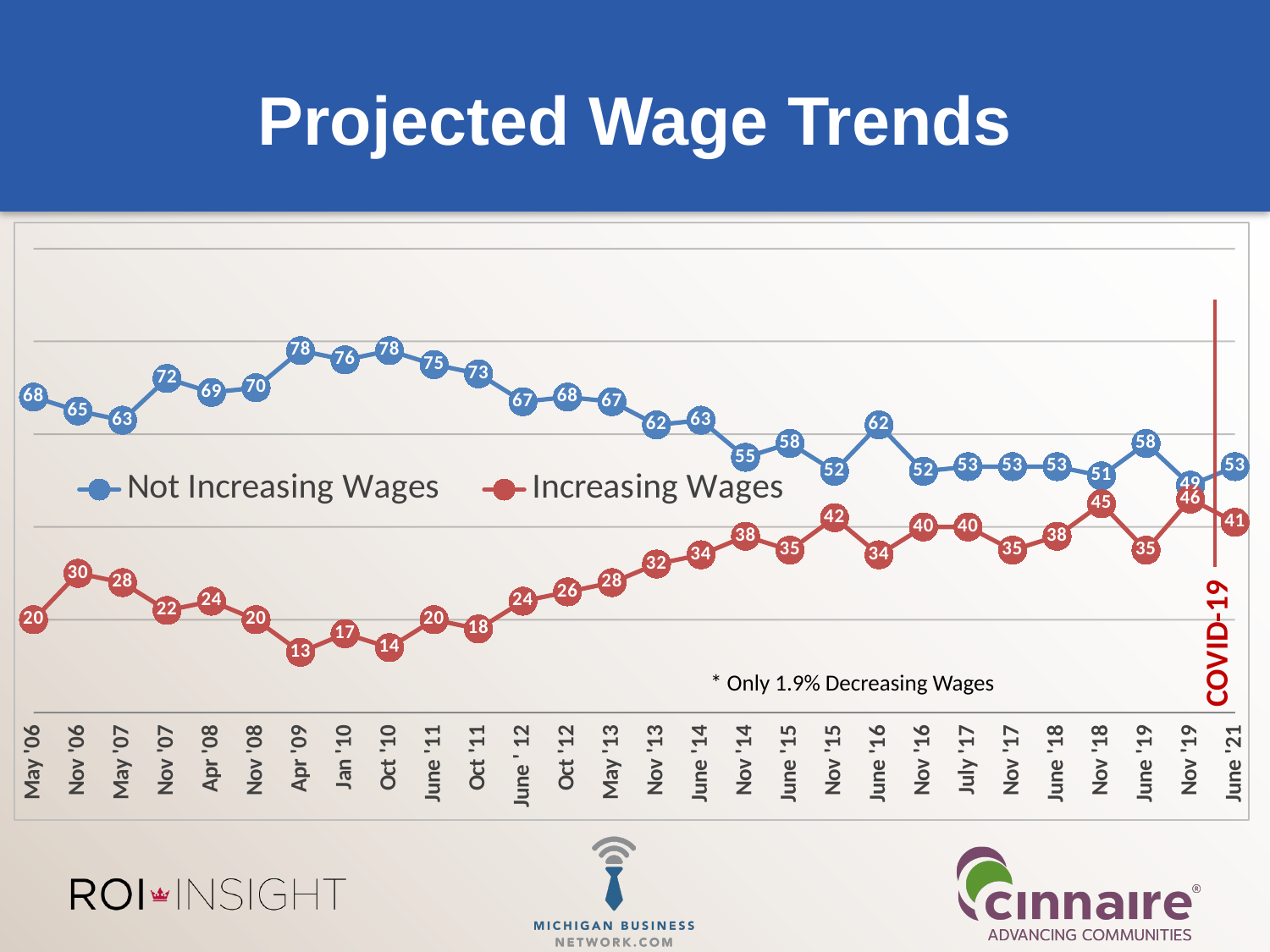
How many series does the legend list? 2 At which date is the Not Increasing Wages series lowest? Nov '19 At which date is the Increasing Wages series highest? Nov '19 At which date is the Increasing Wages series lowest? Apr '09 Which is larger for Increasing Wages: the value at Nov '06 or at May '07? Nov '06 What is the value for Not Increasing Wages at May '06? 68 Does the Increasing Wages series generally rise or fall from Apr '09 to Nov '15? Rise What label is written next to the vertical red line near the right of the chart? COVID-19 What is the value for Increasing Wages at Nov '15? 42 How many dates are shown on the x axis? 28 What kind of chart is shown on the slide? Line chart At June '21, how much higher is Not Increasing Wages than Increasing Wages? 12